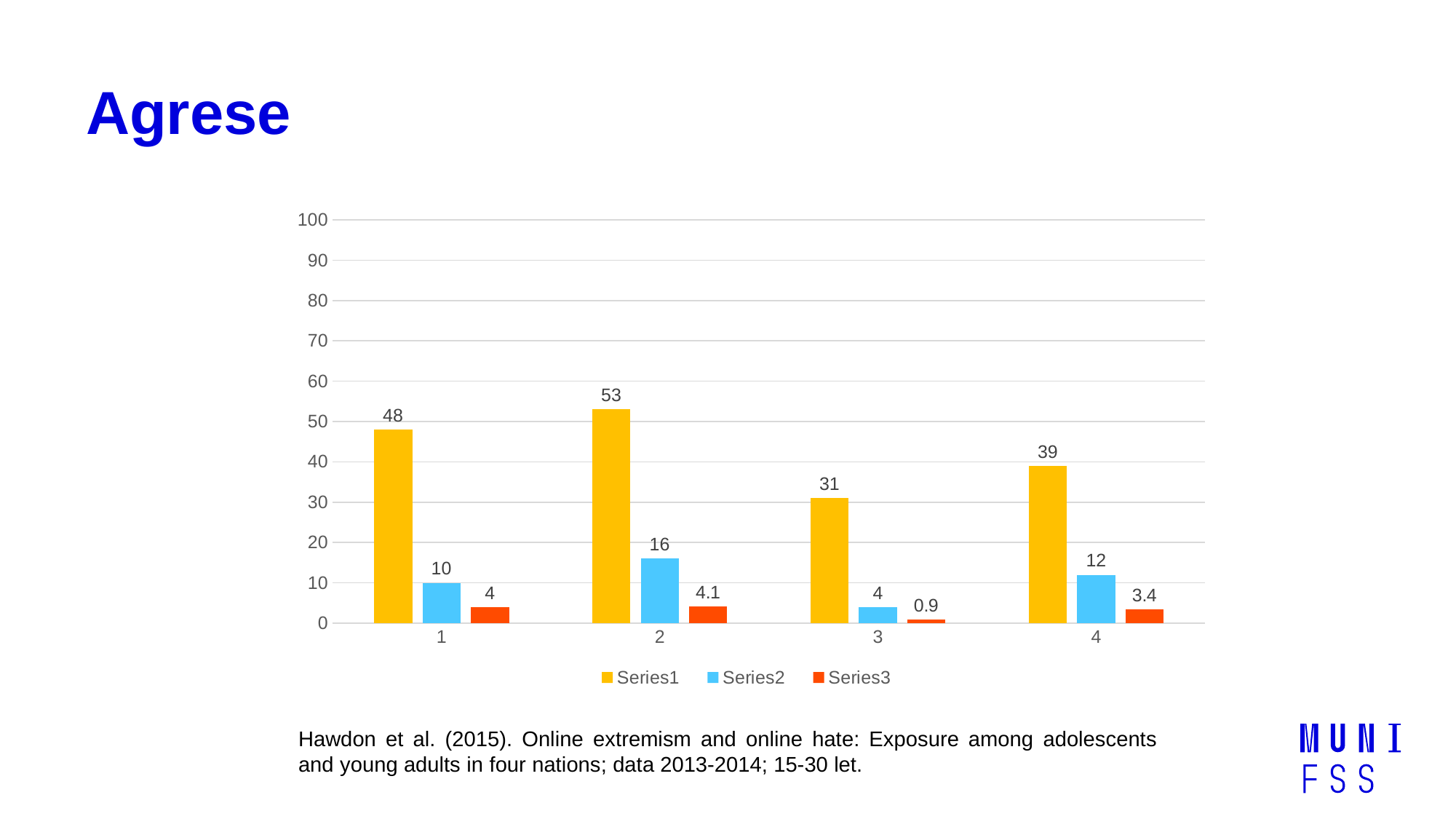
What is the value of Series1 for category 2? 53 How many series does the legend list? 3 What is the difference between the Series1 values for category 1 and category 3? 17 Which is larger: Series3 for category 2 or Series3 for category 4? Series3 for category 2 What is the value of Series2 for category 4? 12 What colour are the Series2 bars? light blue Which category has the lowest Series2 value? 3 What kind of chart is shown on the slide? bar chart Which category has the highest Series1 value? 2 What is the value of Series3 for category 3? 0.9 Is the Series1 value for category 4 greater or less than 30? greater How many categories are shown on the x axis? 4